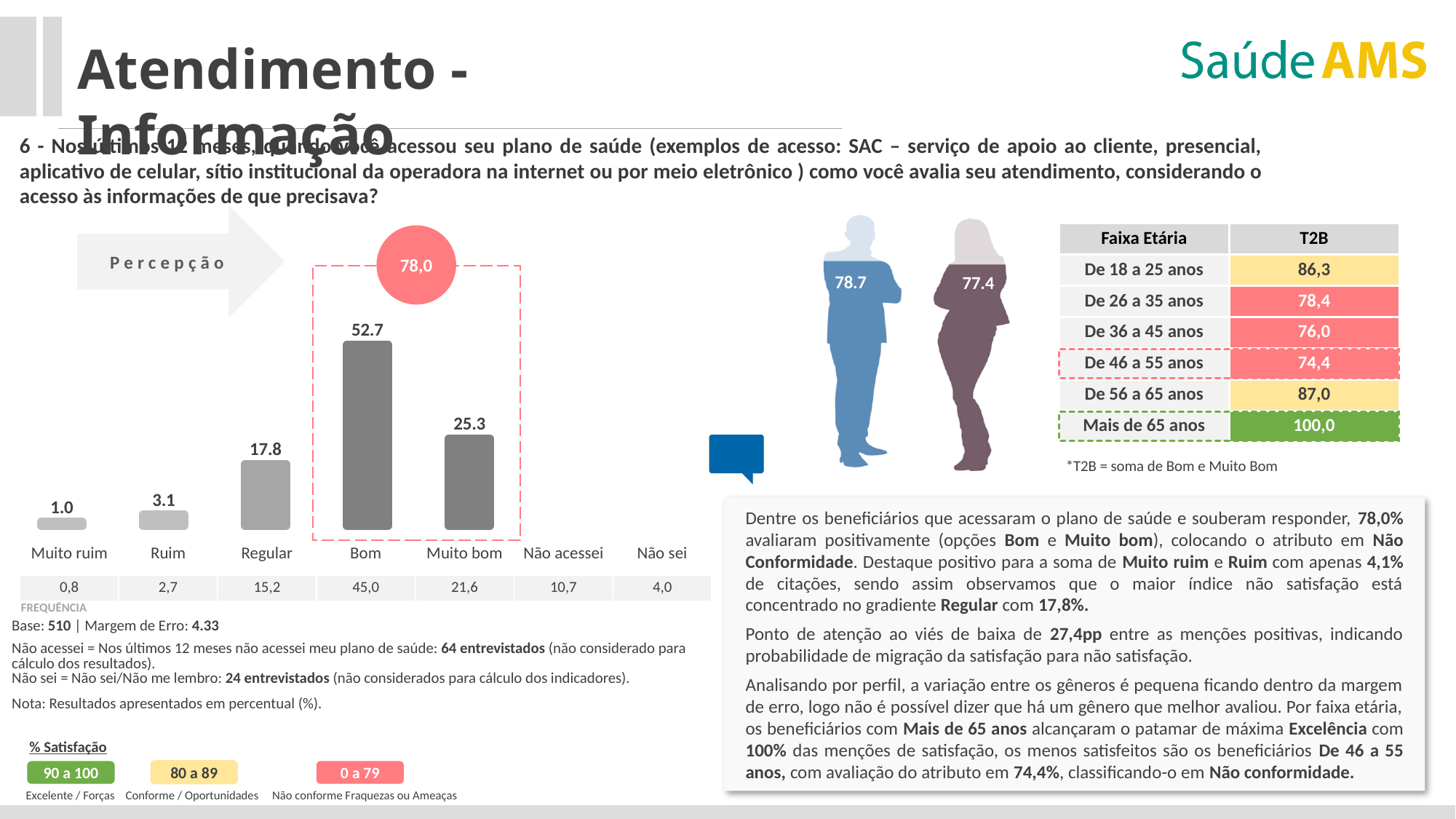
What is the sum of the 'Bom' and 'Muito bom' bar values, as shown in the red circle above the chart? 78,0 Which category has the highest bar in the chart? Bom What is the difference between the 'Bom' and 'Muito bom' bar values? 27.4 How many categories have bars plotted in the chart? 5 What is the value shown for the 'Muito bom' bar? 25.3 What is the value shown for the 'Bom' bar? 52.7 Which is larger, the 'Regular' bar or the 'Ruim' bar? Regular What kind of chart is used to show the evaluation of service information access? bar chart What is the frequency value shown below the chart for 'Não acessei'? 10,7 Which category has the lowest bar among the plotted bars? Muito ruim What is the value shown for the 'Muito ruim' bar? 1.0 What is the value shown for the 'Regular' bar? 17.8